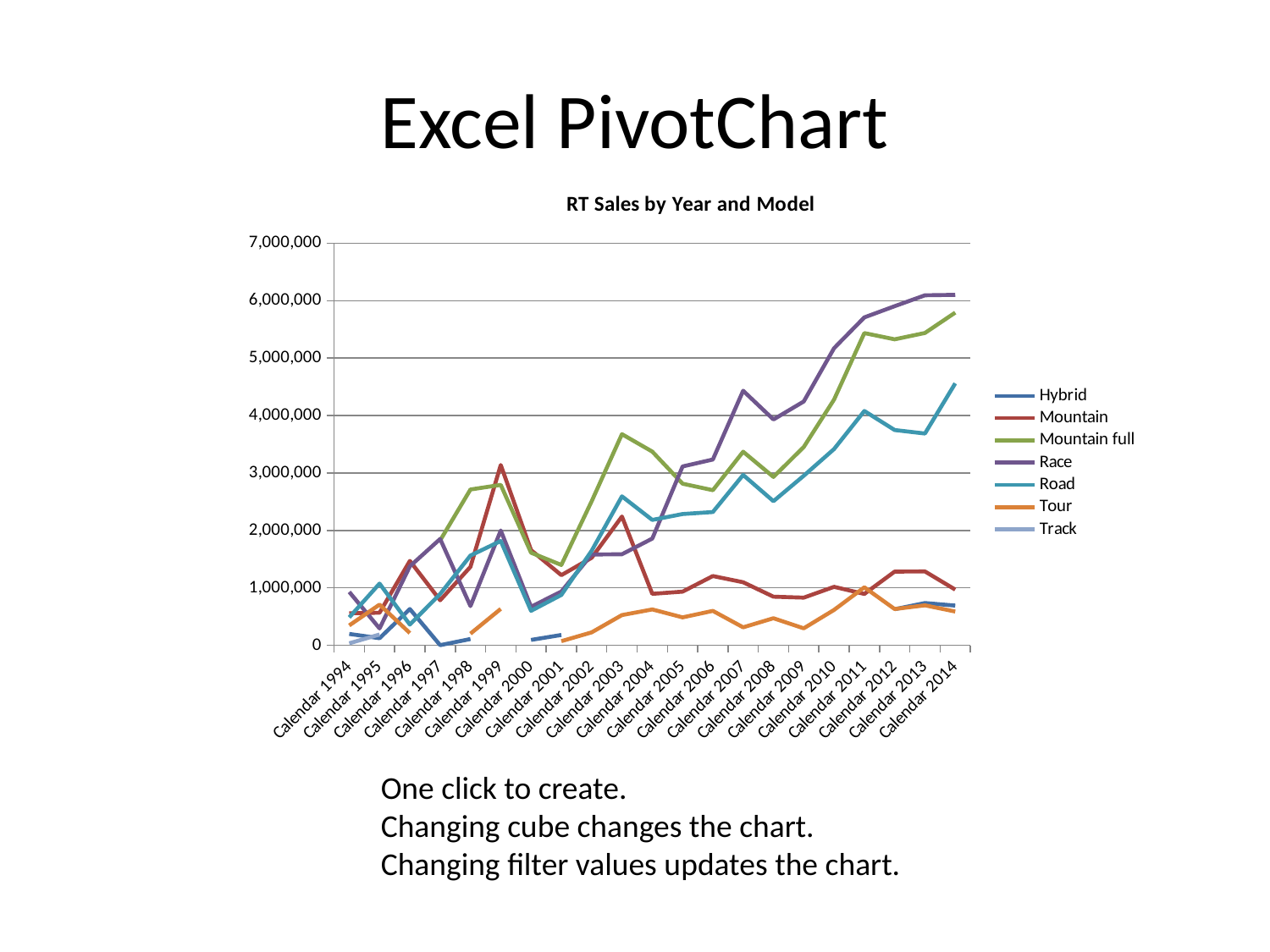
Is the value for Mountain full in Calendar 2003 greater or less than 3,000,000? greater In Calendar 2011, which is larger: Mountain full or Road? Mountain full Which series has the highest value in Calendar 2014? Race How many calendar years are shown on the x axis? 21 What kind of chart is shown on the slide? Line chart Does the Race series rise or fall from Calendar 2009 to Calendar 2014? Rises What is the title of the chart? RT Sales by Year and Model Is the value for Race in Calendar 2014 greater or less than 5,000,000? greater Which series has the lowest value in Calendar 2009? Tour Is the value for Mountain in Calendar 2014 greater or less than 2,000,000? less How many series does the legend list? 7